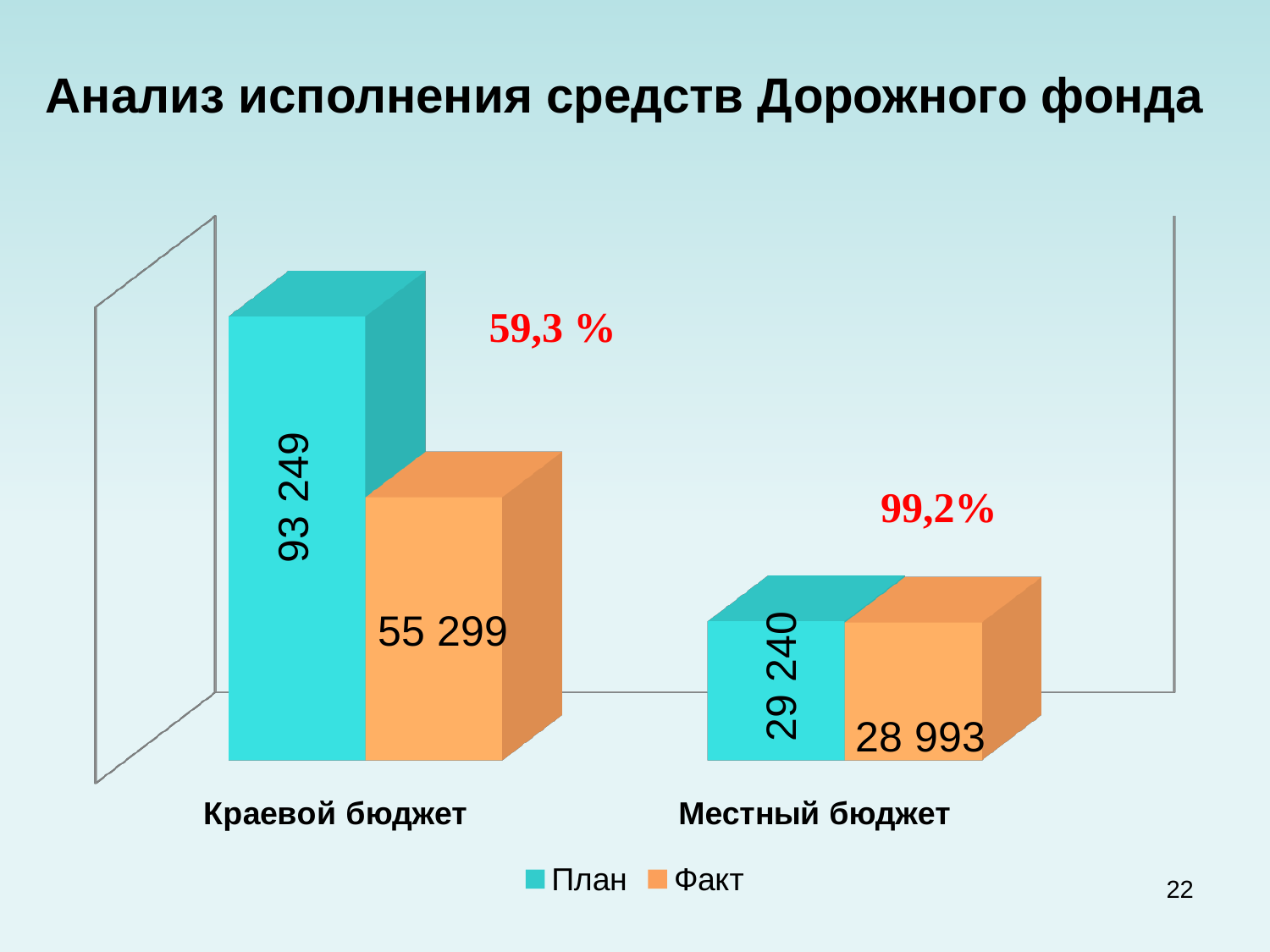
What is the План value for Местный бюджет? 29 240 Which category has the highest План value? Краевой бюджет What is the Факт value for Местный бюджет? 28 993 What percentage is shown above the bars for Местный бюджет? 99,2% What kind of chart is shown on the slide? Bar chart Which category has the lowest Факт value? Местный бюджет Which is larger for Краевой бюджет: План or Факт? План What is the difference between the План and Факт values for Краевой бюджет? 37 950 What is the План value for Краевой бюджет? 93 249 What percentage is shown above the bars for Краевой бюджет? 59,3 % What is the Факт value for Краевой бюджет? 55 299 How many series does the legend list? 2